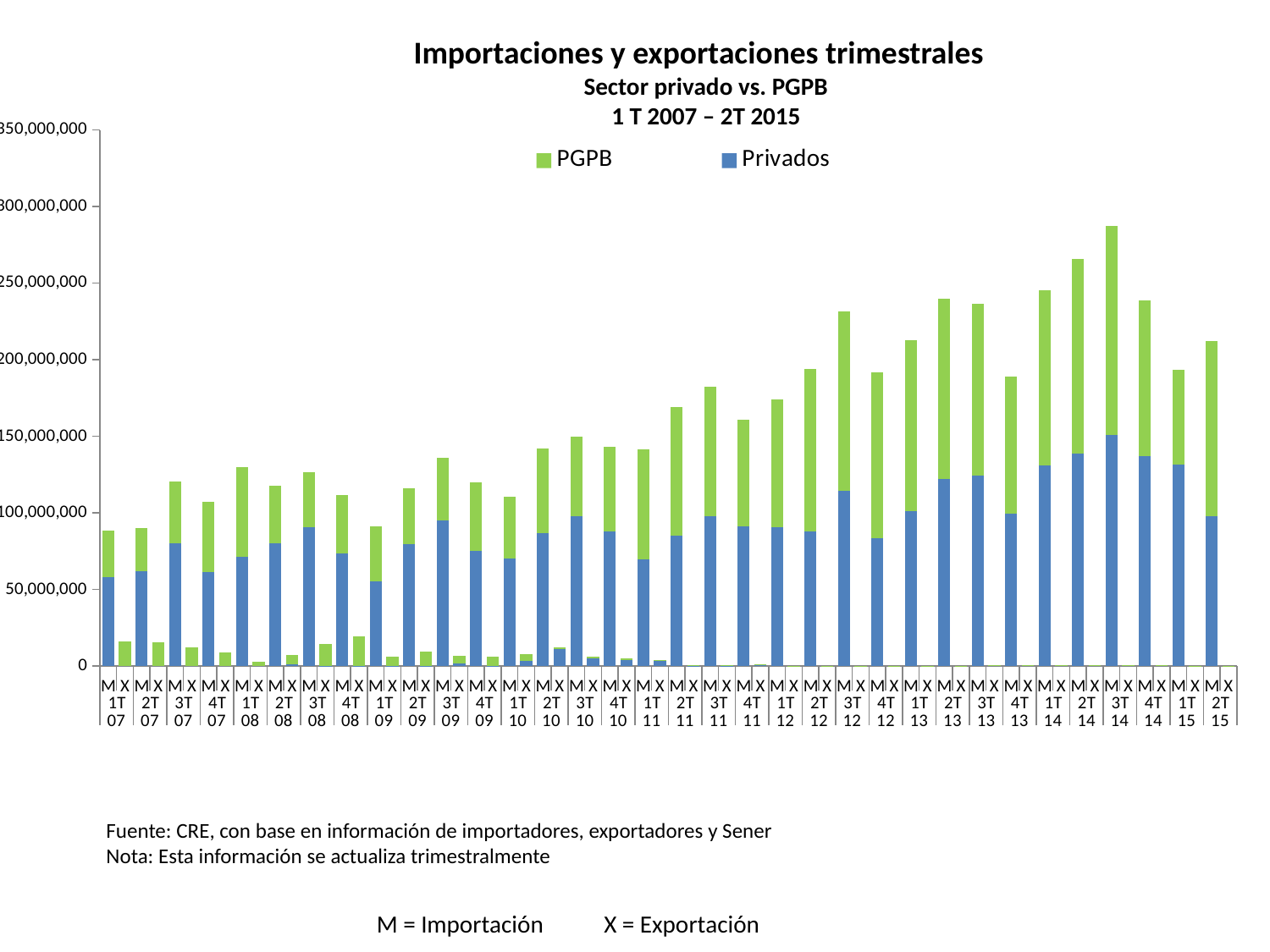
What kind of chart is shown on the slide? Stacked bar chart Is the total value of the M 1T 07 bar greater or less than 100,000,000? less Which bar is the tallest in the chart? M 3T 14 How many series does the legend list? 2 Which series is shown in green? PGPB Is the total value of the M 1T 15 bar greater or less than 200,000,000? less Which bar is taller, M 1T 07 or M 3T 07? M 3T 07 Is the total value of the M 2T 15 bar greater or less than 200,000,000? greater Which bar is taller, M 3T 12 or M 4T 12? M 3T 12 Do the M (importación) bars generally rise or fall from 1T 07 to 3T 14? rise According to the note below the chart, what does M stand for? Importación